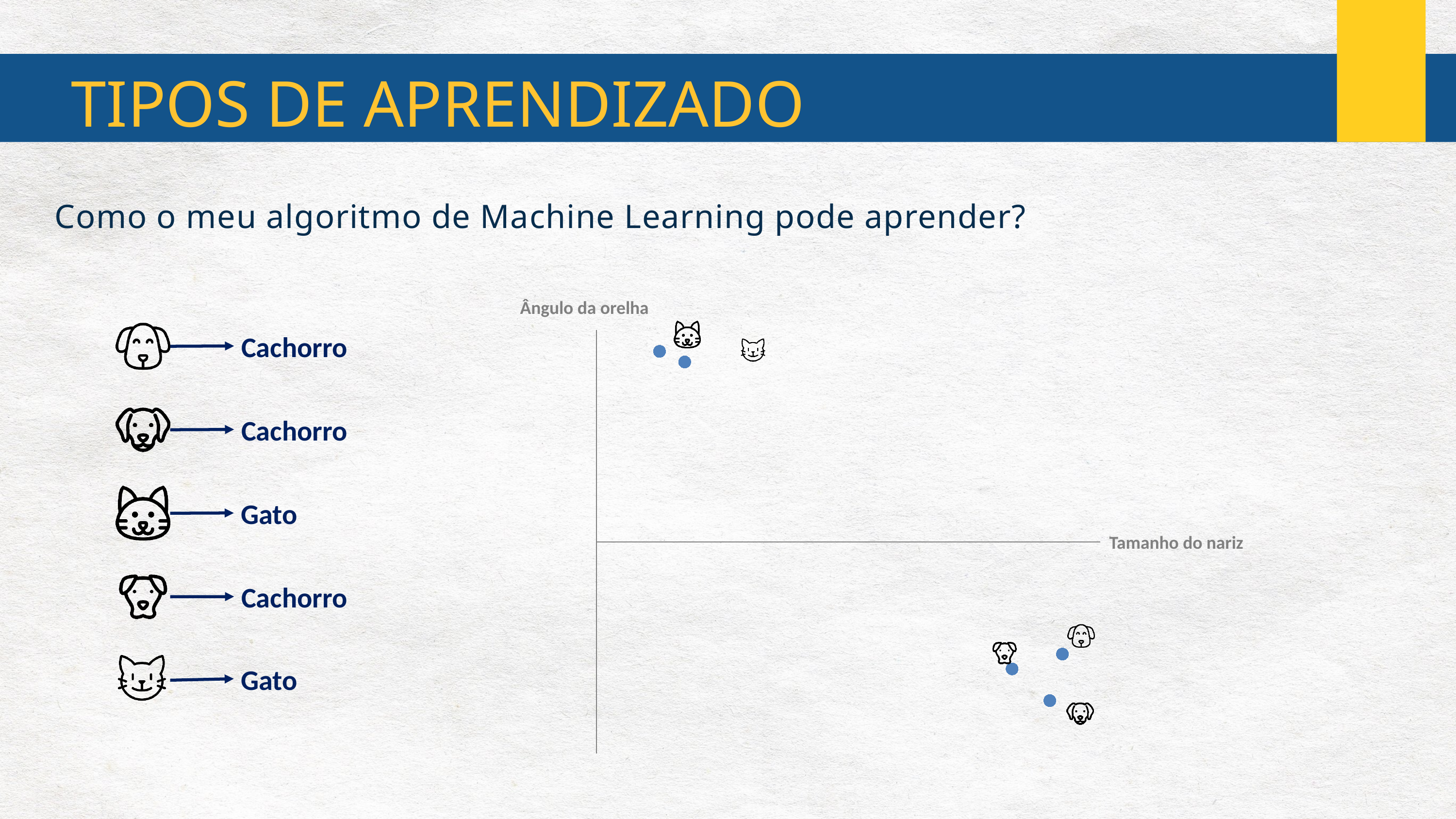
What is the label of the horizontal axis of the chart? Tamanho do nariz Which animal icons are placed next to the points with the largest 'Tamanho do nariz' values? dogs (Cachorro) What is the label of the vertical axis of the chart? Ângulo da orelha Which animal icons are placed next to the points with the highest 'Ângulo da orelha' values? cats (Gato) What kind of chart is shown on the slide? scatter plot How many blue data points are plotted in the lower-right region of the chart, near the dog icons? 3 How many labelled example images are listed to the left of the chart? 5 Do the points with a larger 'Tamanho do nariz' have a higher or lower 'Ângulo da orelha' than the points with a smaller 'Tamanho do nariz'? lower How many blue data points are plotted on the chart? 5